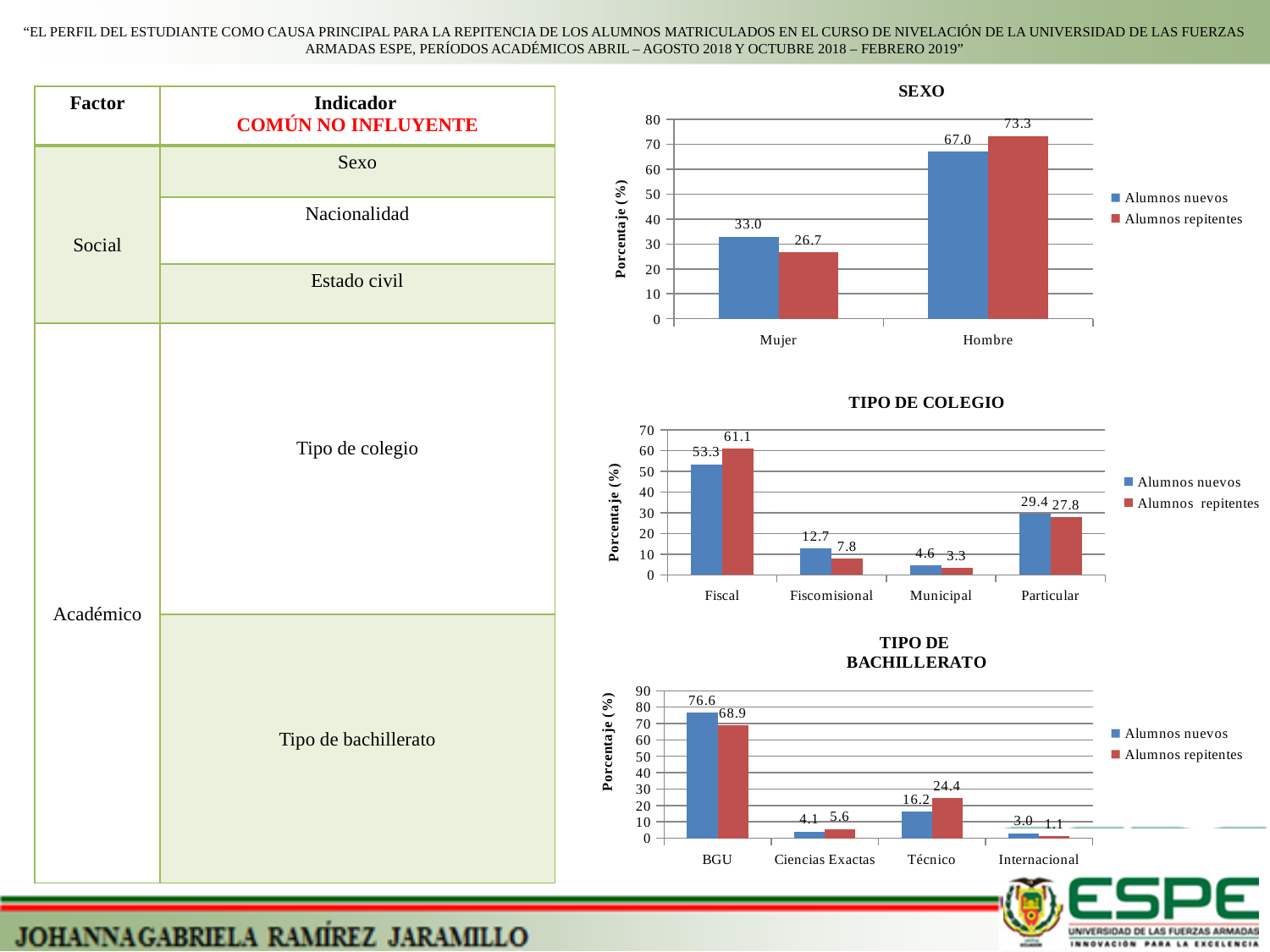
In the TIPO DE BACHILLERATO chart, what is the value for Alumnos nuevos in the BGU category? 76.6 In the TIPO DE BACHILLERATO chart, what is the difference between Alumnos repitentes and Alumnos nuevos for Técnico? 8.2 In the SEXO chart, what is the value for Alumnos nuevos in the Mujer category? 33.0 In the SEXO chart, what is the difference between Alumnos nuevos and Alumnos repitentes for Hombre? 6.3 In the TIPO DE COLEGIO chart, what is the value for Alumnos repitentes in the Fiscal category? 61.1 In the SEXO chart, how many series does the legend list? 2 In the TIPO DE COLEGIO chart, which category has the lowest value for Alumnos nuevos? Municipal In the SEXO chart, what is the value for Alumnos repitentes in the Hombre category? 73.3 In the TIPO DE BACHILLERATO chart, which category has the highest value for Alumnos repitentes? BGU In the TIPO DE COLEGIO chart, which is larger for Fiscomisional: Alumnos nuevos or Alumnos repitentes? Alumnos nuevos In the TIPO DE COLEGIO chart, how many categories are shown on the x axis? 4 What kind of chart is the TIPO DE BACHILLERATO chart? Bar chart